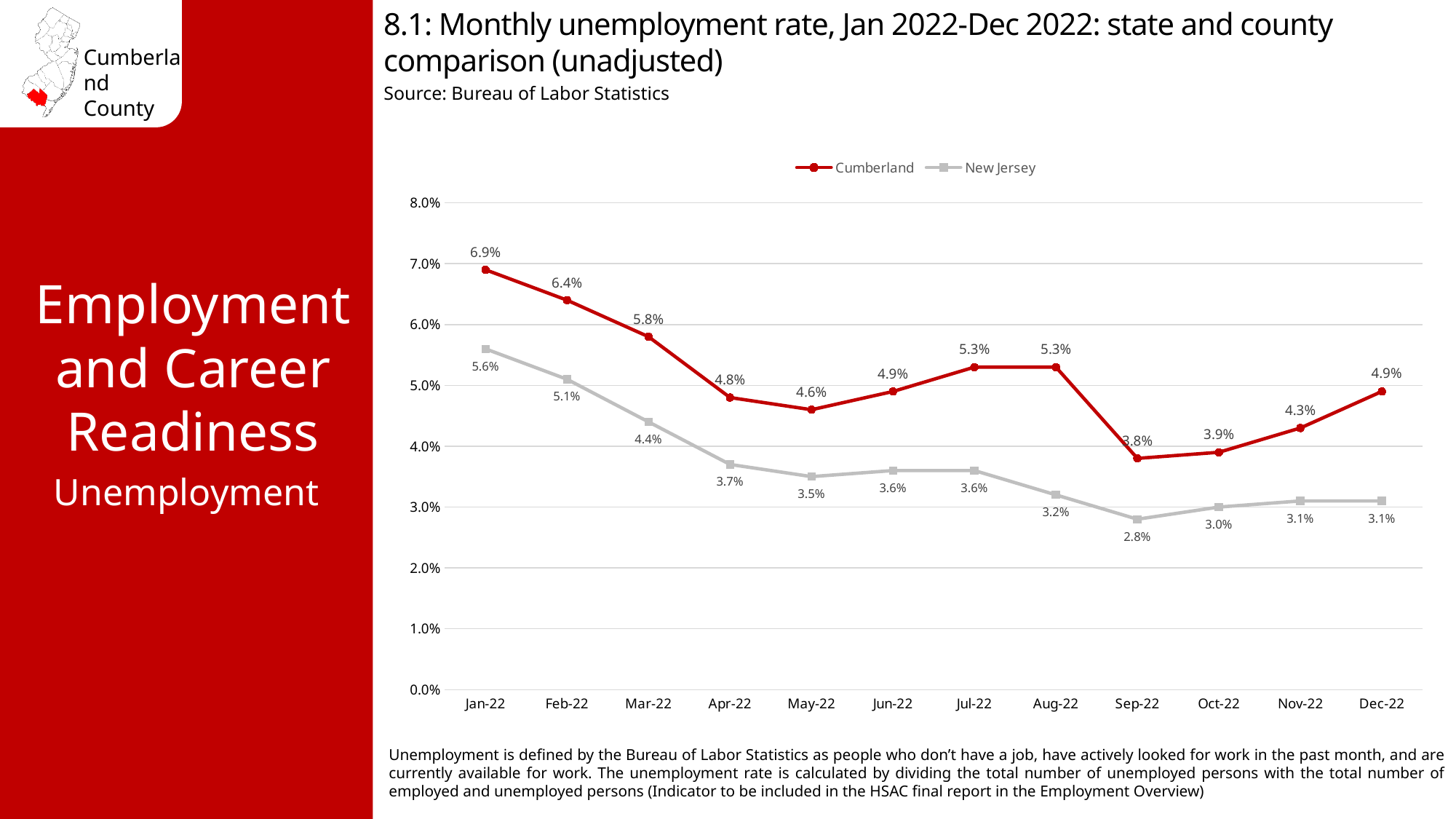
How many series does the legend list? 2 How many months are plotted on the x axis? 12 Did the New Jersey unemployment rate rise or fall from Jan-22 to May-22? Fall What was the New Jersey unemployment rate in Sep-22? 2.8% Is the Cumberland unemployment rate in Mar-22 greater or less than 5.0%? greater In which month was the New Jersey unemployment rate highest? Jan-22 What was the Cumberland unemployment rate in Jan-22? 6.9% Which series had the higher unemployment rate in Apr-22, Cumberland or New Jersey? Cumberland In which month was the Cumberland unemployment rate lowest? Sep-22 What kind of chart is shown on the slide? Line chart What was the Cumberland unemployment rate in Dec-22? 4.9% What is the difference between the Cumberland and New Jersey unemployment rates in Dec-22? 1.8%